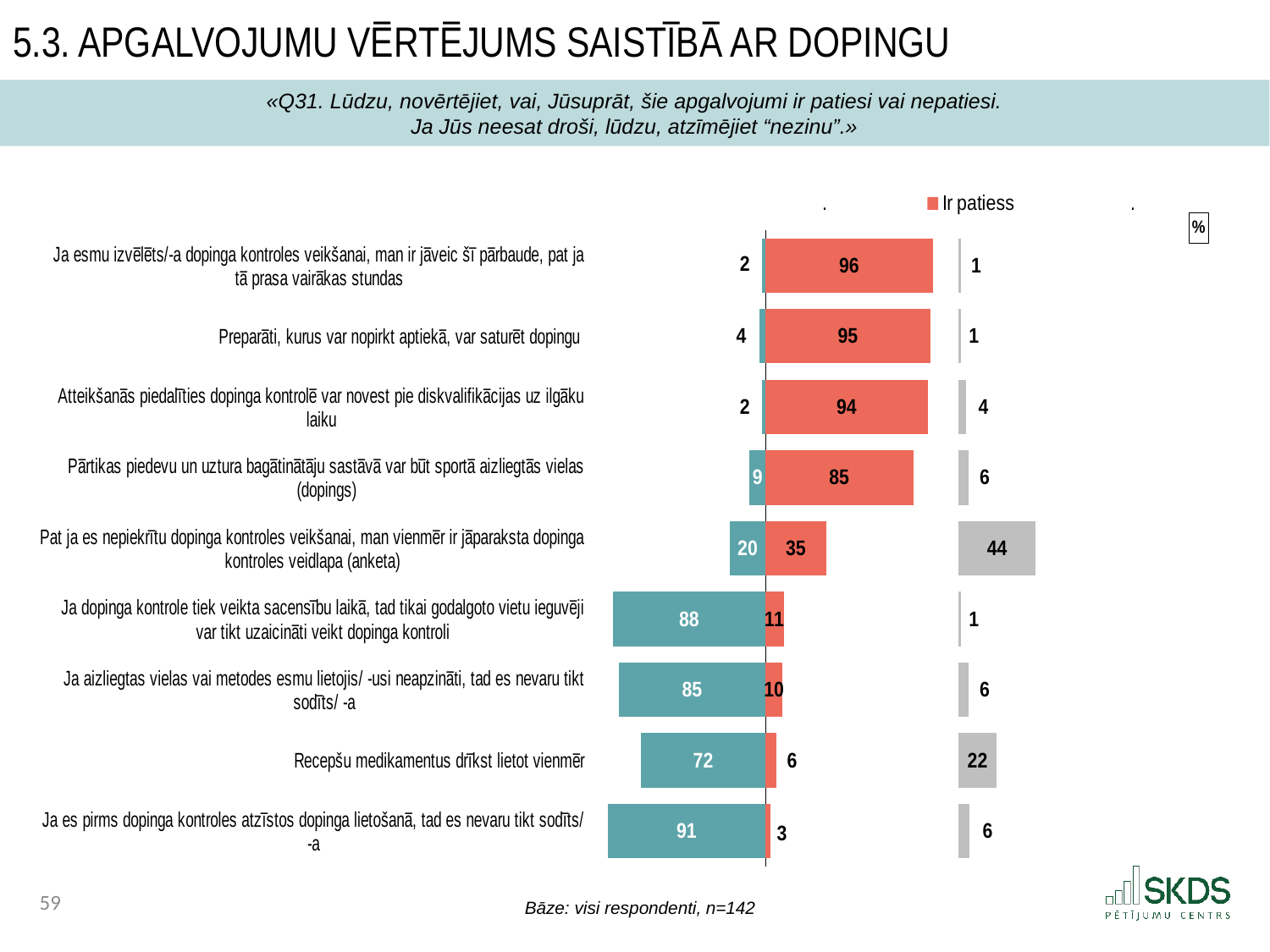
What is the difference between the "Ir patiess" values for "Ja esmu izvēlēts/-a dopinga kontroles veikšanai..." (96) and "Pārtikas piedevu un uztura bagātinātāju sastāvā var būt sportā aizliegtās vielas (dopings)" (85)? 11 What is the difference between the "Ir patiess" values for "Ja dopinga kontrole tiek veikta sacensību laikā..." (11) and "Ja es pirms dopinga kontroles atzīstos dopinga lietošanā..." (3)? 8 What is the "Ir patiess" value for the statement "Preparāti, kurus var nopirkt aptiekā, var saturēt dopingu"? 95 What is the "Ir patiess" value for the statement "Recepšu medikamentus drīkst lietot vienmēr"? 6 What kind of chart is shown on the slide? Bar chart What is the "Ir patiess" value for the statement "Pat ja es nepiekrītu dopinga kontroles veikšanai, man vienmēr ir jāparaksta dopinga kontroles veidlapa (anketa)"? 35 What colour are the "Ir patiess" bars in the chart? Red Which statement has the highest "Ir patiess" value? Ja esmu izvēlēts/-a dopinga kontroles veikšanai, man ir jāveic šī pārbaude, pat ja tā prasa vairākas stundas Which has a larger "Ir patiess" value: "Atteikšanās piedalīties dopinga kontrolē var novest pie diskvalifikācijas uz ilgāku laiku" or "Ja aizliegtas vielas vai metodes esmu lietojis/-usi neapzināti, tad es nevaru tikt sodīts/-a"? Atteikšanās piedalīties dopinga kontrolē var novest pie diskvalifikācijas uz ilgāku laiku How many statements are listed in the chart? 9 Which legend entry is readable on the chart? Ir patiess Which statement has the lowest "Ir patiess" value? Ja es pirms dopinga kontroles atzīstos dopinga lietošanā, tad es nevaru tikt sodīts/-a